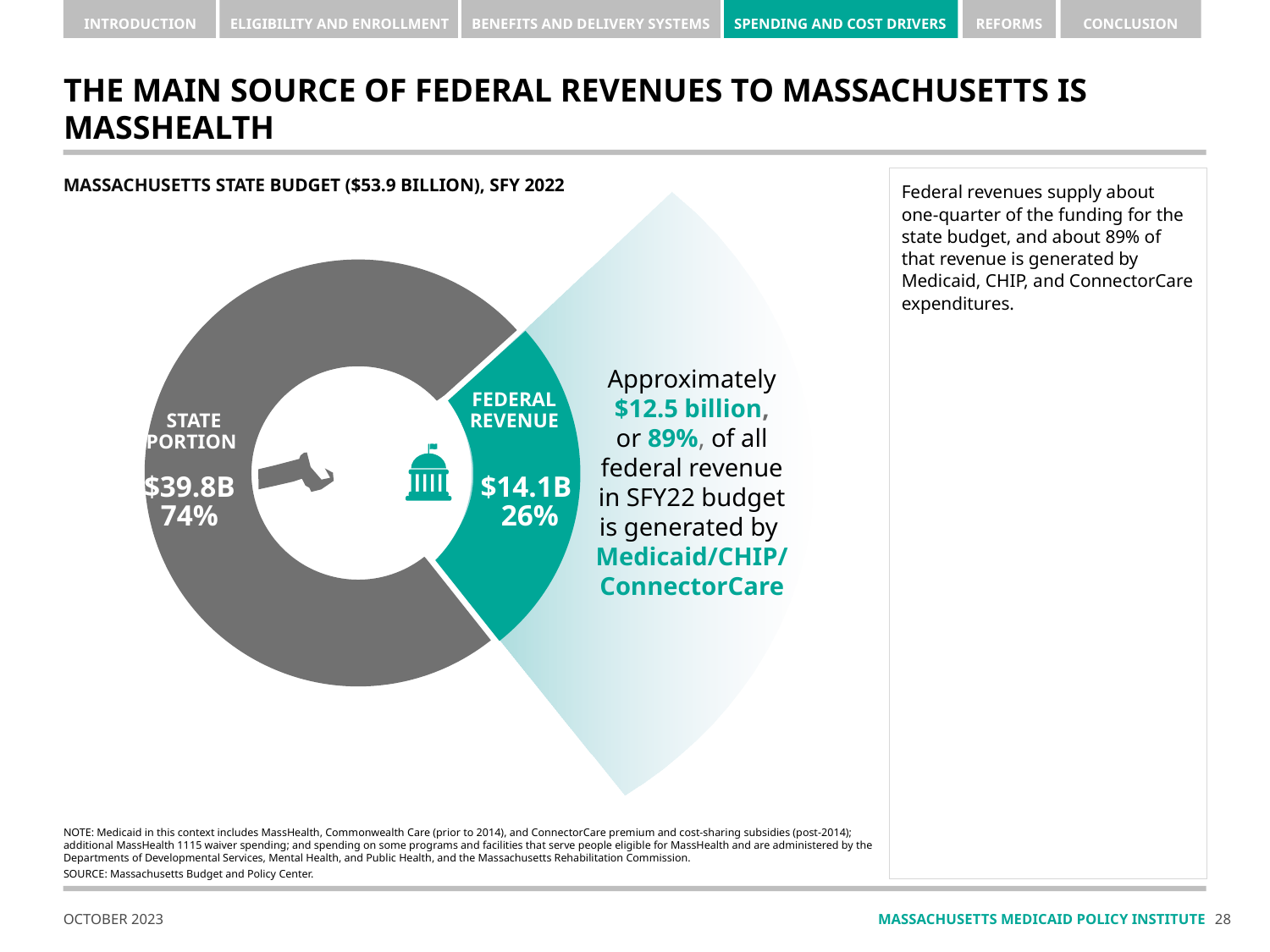
What share of the state budget is Federal Revenue? 26% What colour is the Federal Revenue slice? Teal What share of the state budget is the State Portion? 74% What kind of chart is shown on the slide? Pie chart (donut) What is the difference in dollars between the State Portion and Federal Revenue? $25.7B How many slices does the chart have? 2 Which slice is larger, State Portion or Federal Revenue? State Portion Which slice of the chart is the smallest? Federal Revenue According to the callout, approximately how much of federal revenue in the SFY22 budget is generated by Medicaid/CHIP/ConnectorCare? $12.5 billion What is the dollar value of the Federal Revenue slice? $14.1B What is the dollar value of the State Portion slice? $39.8B What is the total state budget shown in the chart title? $53.9 billion